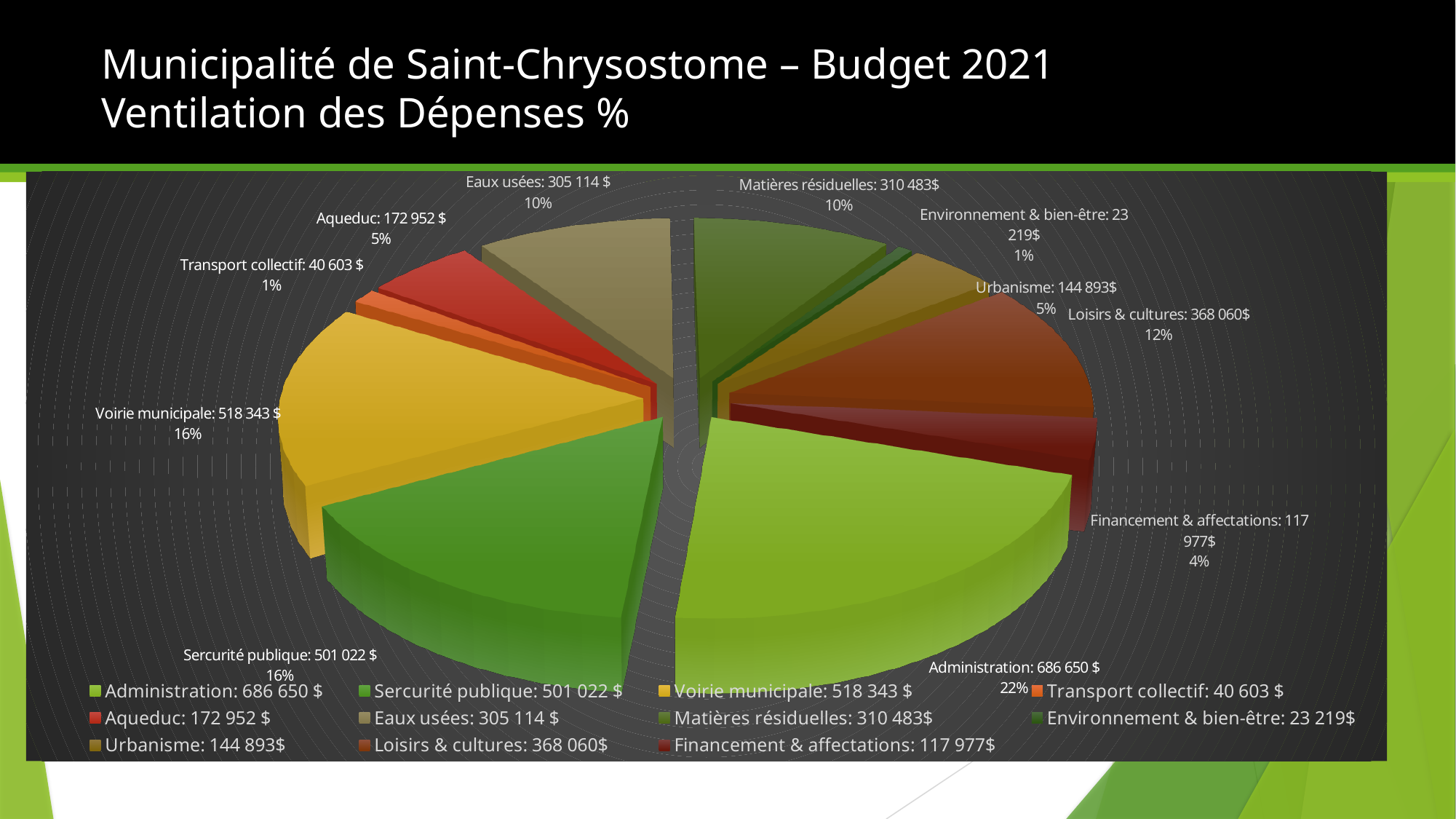
Which category has the largest slice of the pie? Administration What share of the pie does Administration represent? 22% How many slices does the pie chart have? 11 What is the dollar amount shown for Eaux usées? 305 114 $ What is the difference in percentage points between the Administration share and the Voirie municipale share? 6% What is the dollar amount shown for Voirie municipale? 518 343 $ What kind of chart is shown on the slide? pie chart Which is larger, the slice for Loisirs & cultures or the slice for Urbanisme? Loisirs & cultures How many entries does the legend list? 11 What is the dollar amount shown for Environnement & bien-être? 23 219$ What share of the pie does Loisirs & cultures represent? 12% What share of the pie does Financement & affectations represent? 4%